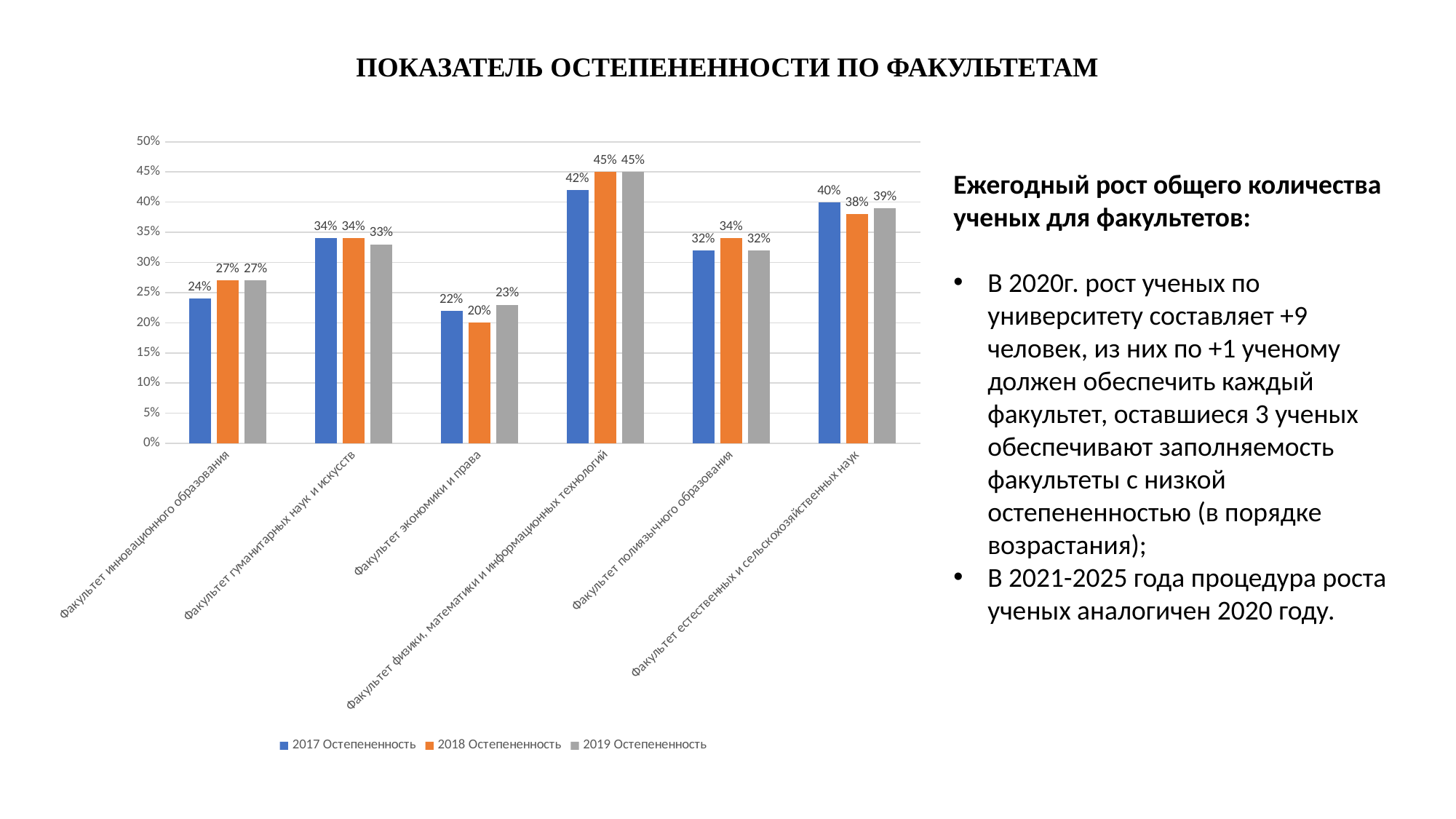
Which is larger: the 2017 Остепененность value for Факультет полиязычного образования or for Факультет естественных и сельскохозяйственных наук? Факультет естественных и сельскохозяйственных наук What is the 2018 Остепененность value for Факультет экономики и права? 20% What is the difference between the 2018 and 2017 Остепененность values for Факультет физики, математики и информационных технологий? 3% Is the 2019 Остепененность value for Факультет гуманитарных наук и искусств greater or less than 30%? greater Which faculty has the highest 2019 Остепененность value? Факультет физики, математики и информационных технологий What is the 2017 Остепененность value for Факультет инновационного образования? 24% How many faculties (categories) are shown on the x axis of the chart? 6 What type of chart is shown on the slide? Bar chart What is the title of the chart on the slide? ПОКАЗАТЕЛЬ ОСТЕПЕНЕННОСТИ ПО ФАКУЛЬТЕТАМ What is the 2019 Остепененность value for Факультет естественных и сельскохозяйственных наук? 39% How many series does the chart legend list? 3 Which faculty has the lowest 2018 Остепененность value? Факультет экономики и права